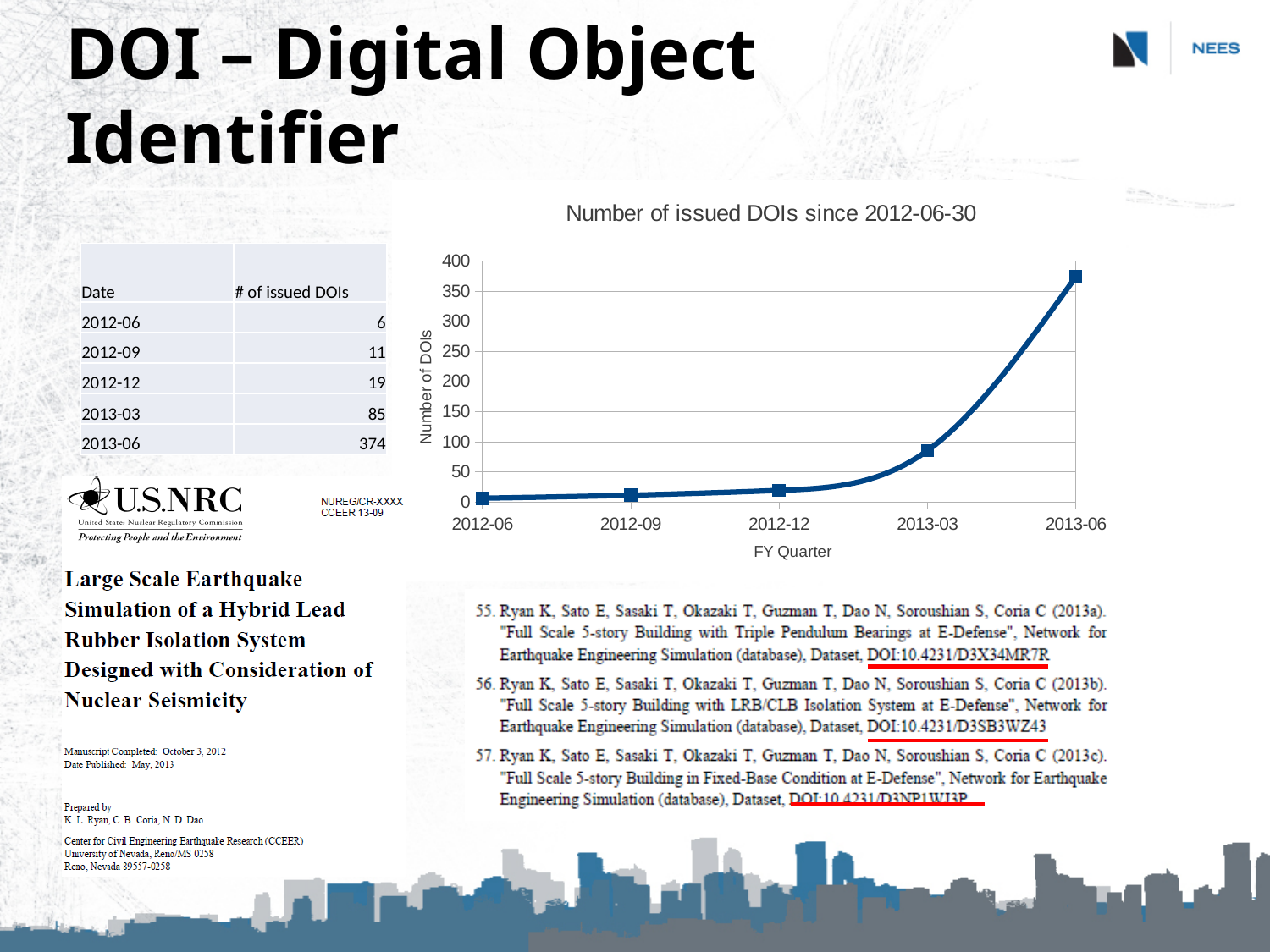
What is the number of issued DOIs for 2013-06? 374 How many data points are plotted on the chart? 5 What is the number of issued DOIs for 2013-03? 85 What is the label of the x axis of the chart? FY Quarter Is the value for 2013-03 greater or less than 100? less Which FY quarter has the highest number of issued DOIs? 2013-06 What is the title of the chart? Number of issued DOIs since 2012-06-30 What is the difference in the number of issued DOIs between 2013-06 and 2013-03? 289 What kind of chart is shown on the slide? line chart Which FY quarter has the lowest number of issued DOIs? 2012-06 Is the value for 2013-06 greater or less than 350? greater Do the values rise or fall along the x axis from 2012-06 to 2013-06? rise